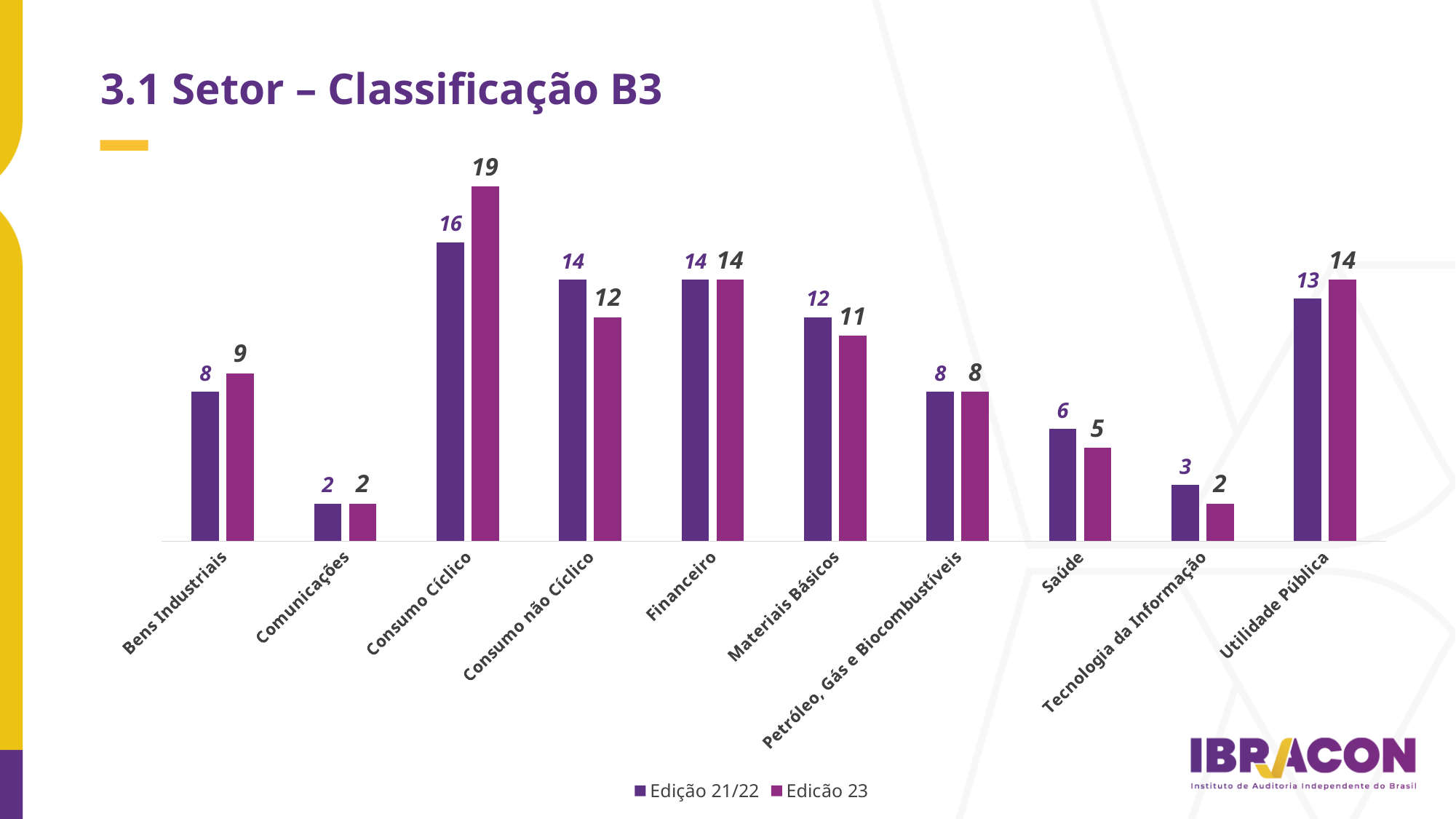
What kind of chart is shown on the slide? Bar chart Which is larger for Consumo não Cíclico: the Edição 21/22 value or the Edição 23 value? Edição 21/22 What is the value for Utilidade Pública in the Edição 21/22 series? 13 What are the two series listed in the legend? Edição 21/22 and Edição 23 What is the value for Consumo Cíclico in the Edição 23 series? 19 Which category has the highest value in the Edição 23 series? Consumo Cíclico What is the title of the slide? 3.1 Setor – Classificação B3 How many categories are shown on the x axis? 10 How many series does the legend list? 2 What is the value for Saúde in the Edição 21/22 series? 6 What is the difference between the Edição 23 and Edição 21/22 values for Consumo Cíclico? 3 Which category has the lowest value in the Edição 21/22 series? Comunicações